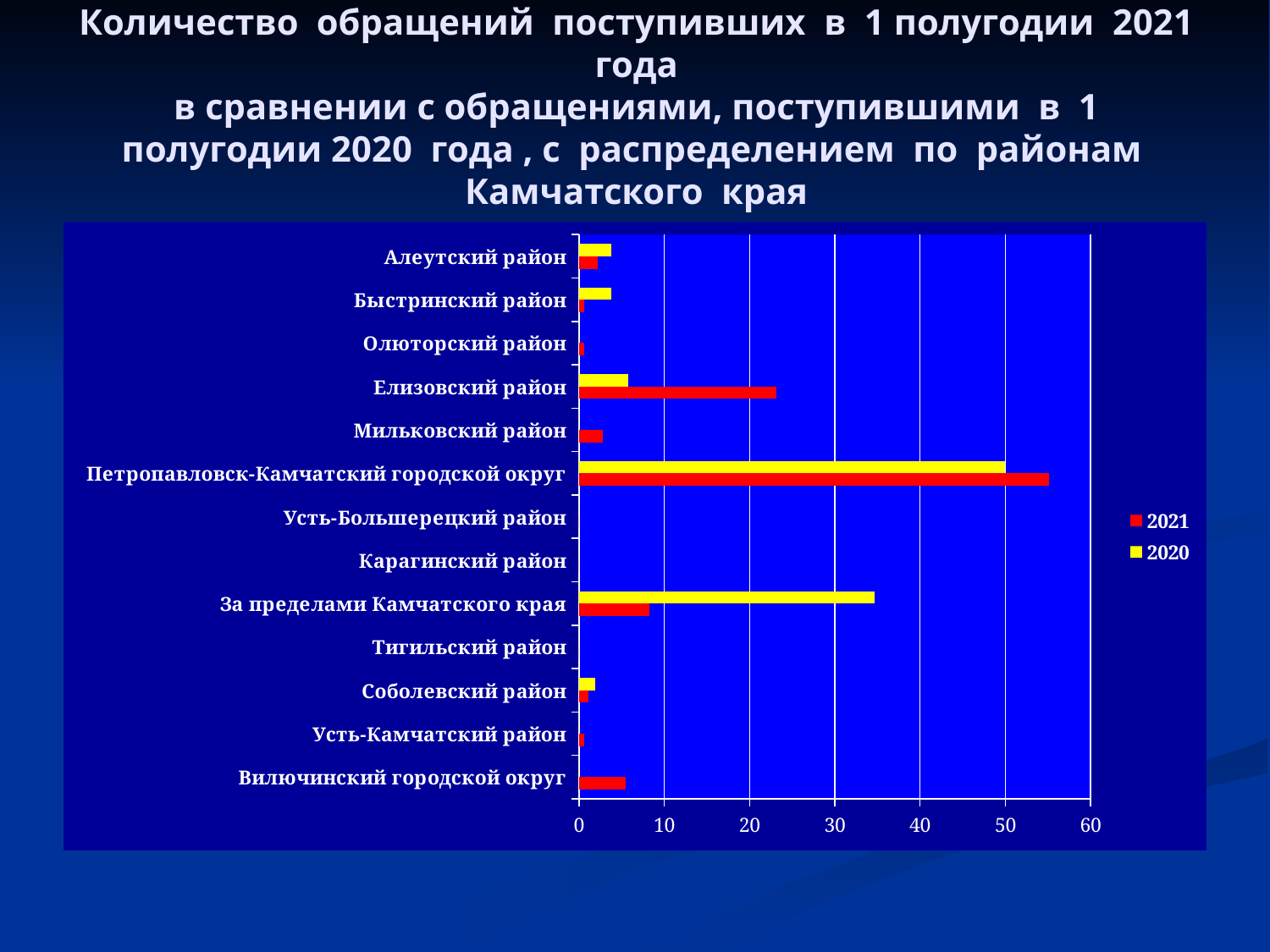
How many districts (categories) are listed on the vertical axis of the chart? 13 For За пределами Камчатского края, which year has the larger value, 2021 or 2020? 2020 What kind of chart is shown on the slide? bar chart For Елизовский район, which year has the larger value, 2021 or 2020? 2021 Is the 2021 value for Петропавловск-Камчатский городской округ greater or less than 50? greater How many series does the legend list? 2 Which district has the highest value for 2020? Петропавловск-Камчатский городской округ What colour represents the 2021 series in the legend? red Is the 2020 value for За пределами Камчатского края greater or less than 30? greater Is the 2021 value for Елизовский район greater or less than 20? greater Which district has the highest value for 2021? Петропавловск-Камчатский городской округ